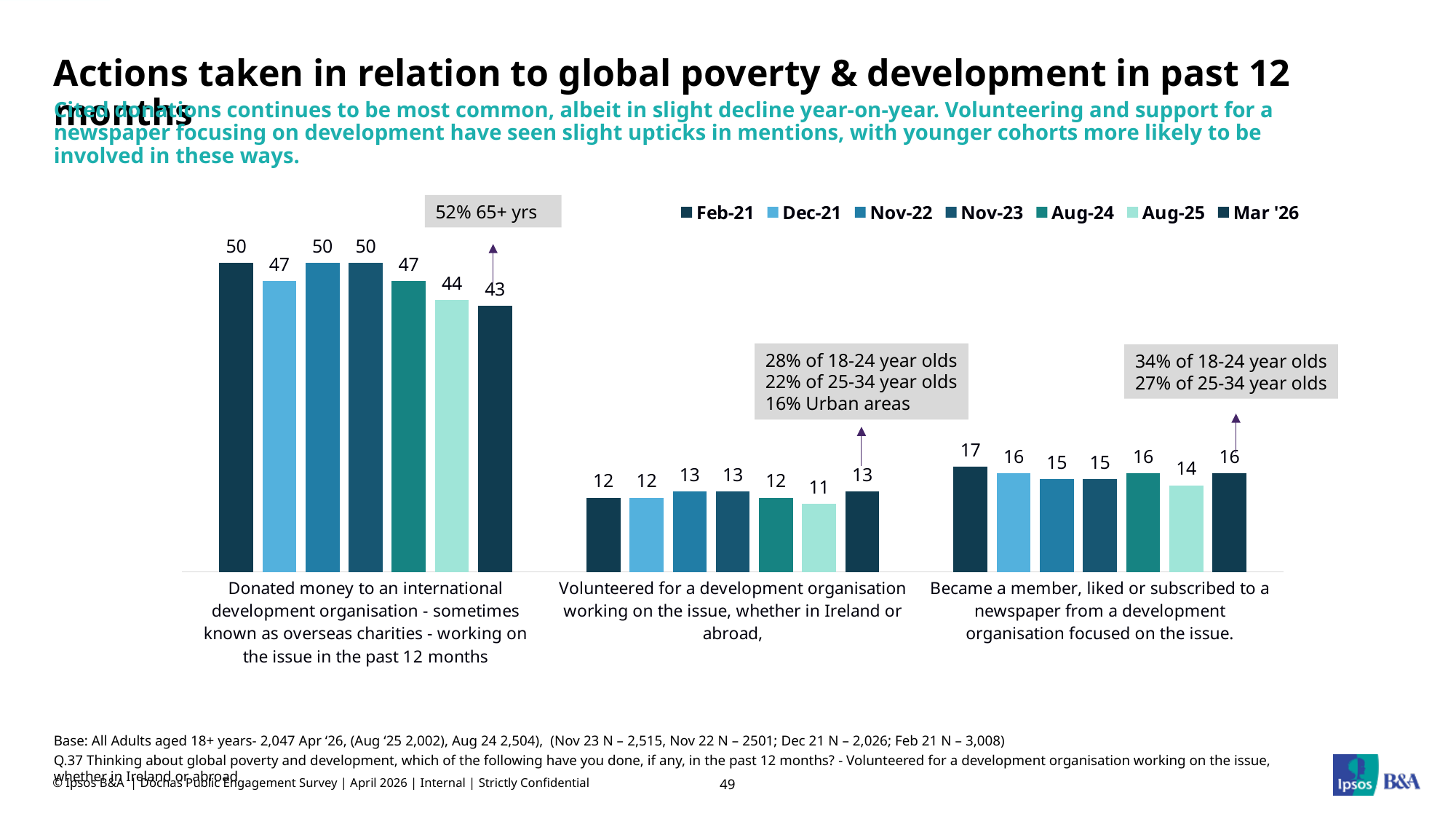
How many series does the legend list? 7 What does the callout above the Mar '26 bar for "Donated money" say? 52% 65+ yrs What is the difference between the Mar '26 and Aug-25 values for "Volunteered for a development organisation"? 2 What kind of chart is shown on the slide? Bar chart What is the Aug-25 value for "Volunteered for a development organisation working on the issue"? 11 What is the Feb-21 value for "Became a member, liked or subscribed to a newspaper from a development organisation"? 17 Which series has the lowest value for "Became a member, liked or subscribed to a newspaper from a development organisation"? Aug-25 How many categories are shown on the x axis? 3 What is the difference between the Feb-21 and Mar '26 values for "Donated money to an international development organisation"? 7 What is the Mar '26 value for "Donated money to an international development organisation"? 43 Which is larger for "Became a member, liked or subscribed to a newspaper": the Feb-21 value or the Aug-25 value? Feb-21 Which series has the lowest value for "Donated money to an international development organisation"? Mar '26